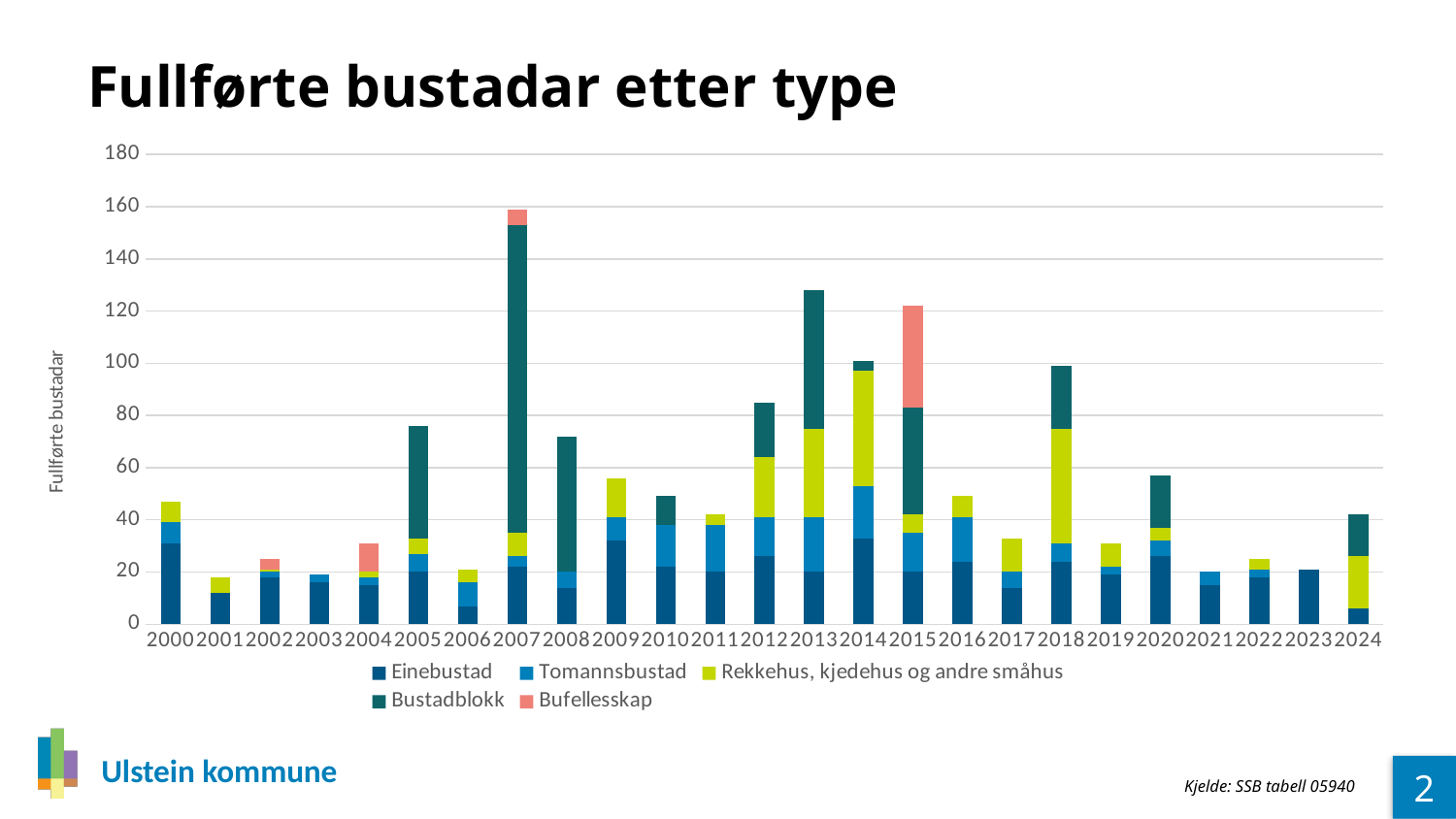
Is the total for 2007 greater or less than 140? greater How many series does the legend list? 5 Is the total for 2016 greater or less than 60? less Which series is shown in the salmon/pink colour in the legend? Bufellesskap Which year has the highest total of completed dwellings? 2007 Is the total for 2008 greater or less than 60? greater What is the title of the chart? Fullførte bustadar etter type How many years are shown along the x axis? 25 Which year has the larger total, 2007 or 2013? 2007 What kind of chart is shown on the slide? Stacked bar chart